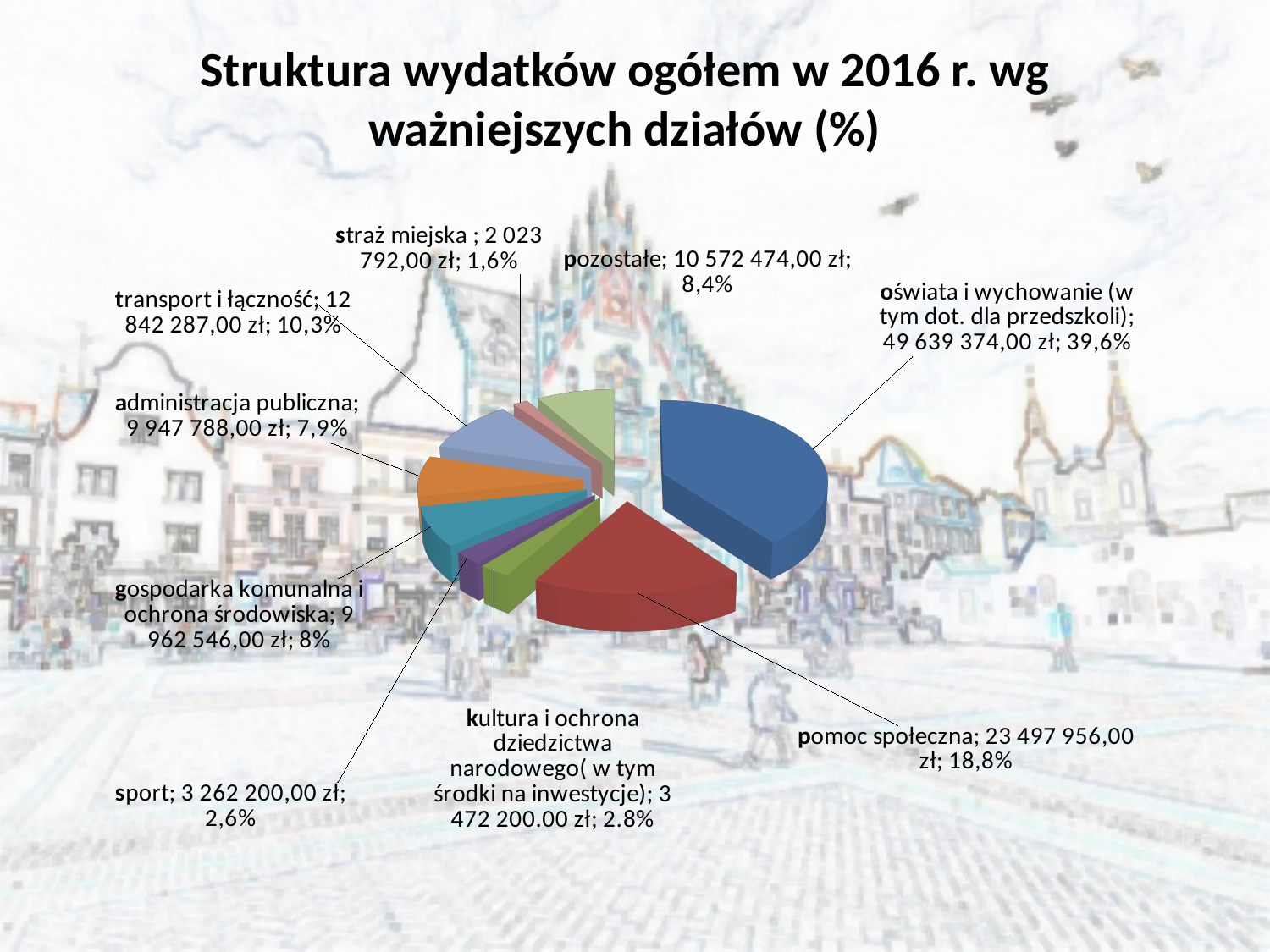
Which has a larger share: 'pomoc społeczna' or 'transport i łączność'? pomoc społeczna Which category has the smallest share of the pie chart? straż miejska What kind of chart is shown on the slide? pie chart What is the title of the chart on the slide? Struktura wydatków ogółem w 2016 r. wg ważniejszych działów (%) What is the difference in percentage points between 'oświata i wychowanie' (39,6%) and 'pomoc społeczna' (18,8%)? 20,8 How many categories (slices) does the pie chart show? 9 What is the amount shown for 'transport i łączność'? 12 842 287,00 zł What is the amount shown for 'pomoc społeczna'? 23 497 956,00 zł What is the amount shown for 'sport'? 3 262 200,00 zł Which category has the largest share of the pie chart? oświata i wychowanie What percentage share does 'straż miejska' have? 1,6% What percentage share does 'oświata i wychowanie' have in the pie chart? 39,6%